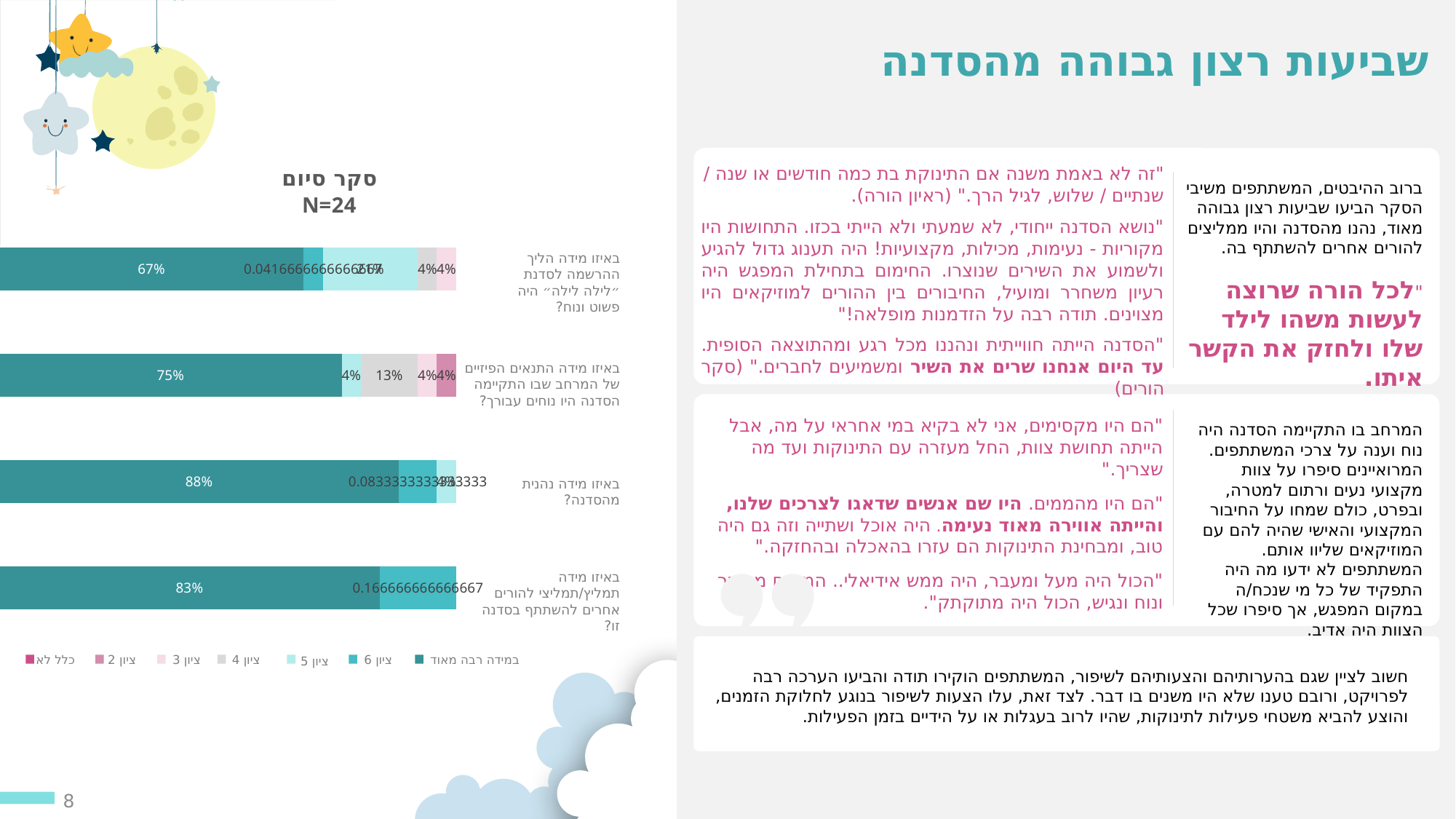
Which question has the lowest share of 'במידה רבה מאוד' responses? באיזו מידה הליך ההרשמה לסדנת ״לילה לילה״ היה פשוט ונוח? What share of respondents answered 'במידה רבה מאוד' to 'באיזו מידה נהנית מהסדנה?'? 88% What share of respondents answered 'במידה רבה מאוד' to the question about the physical conditions (התנאים הפיזיים) of the workshop space? 75% What share of respondents answered 'במידה רבה מאוד' to the question about recommending the workshop to other parents? 83% What share of respondents gave 'ציון 4' for the question about the physical conditions of the workshop space? 13% What kind of chart is shown on the slide? Stacked bar chart Which question has the highest share of 'במידה רבה מאוד' responses? באיזו מידה נהנית מהסדנה? How many question categories are plotted in the chart? 4 How many series does the chart legend list? 7 What share of respondents answered 'במידה רבה מאוד' to the question about whether the registration process (הליך ההרשמה) was simple and convenient? 67% What is the title of the chart? סקר סיום N=24 What is the difference in percentage points between the 'במידה רבה מאוד' share for enjoying the workshop (88%) and for the registration process (67%)? 21 percentage points